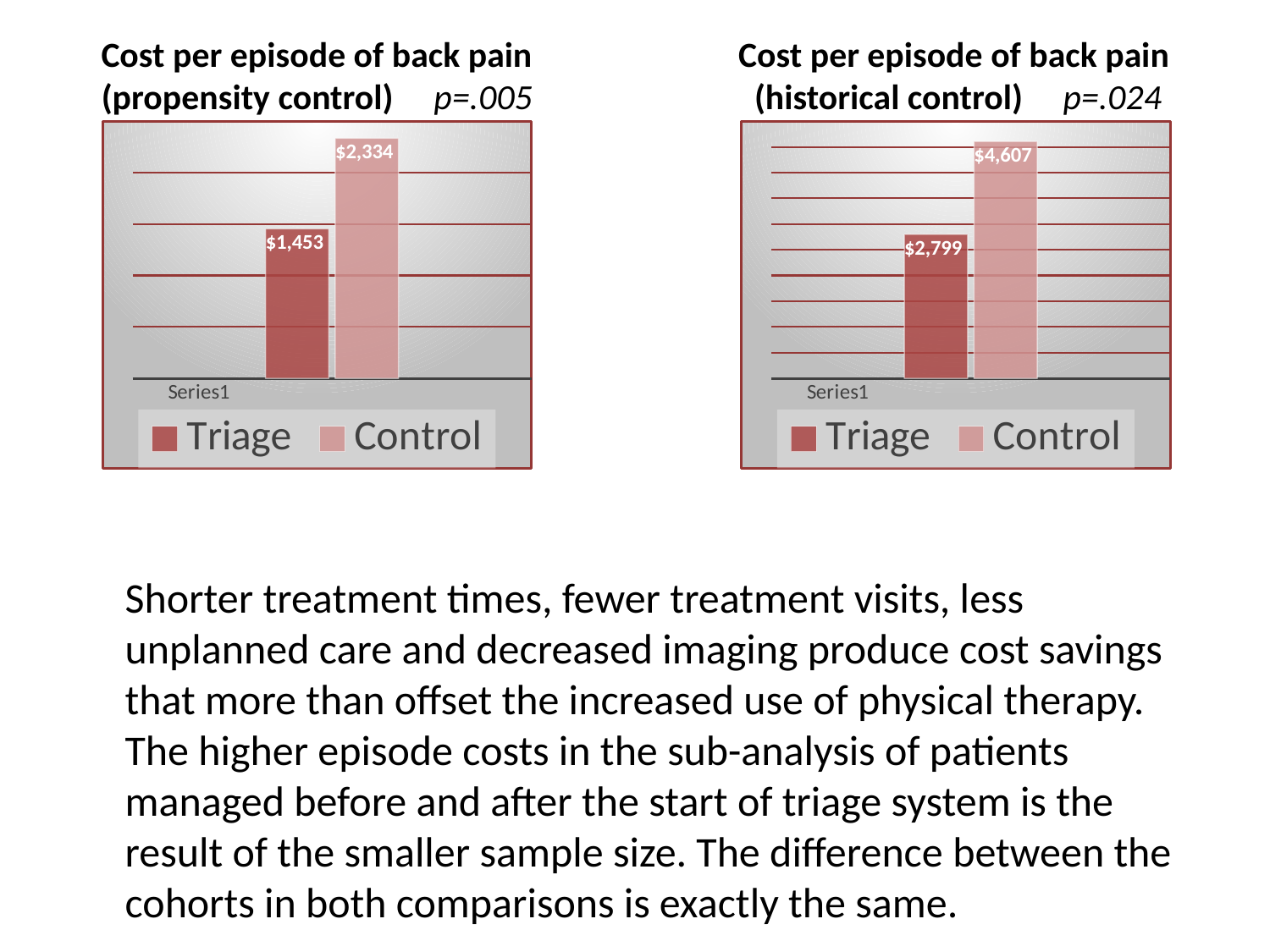
How many series does the legend of the historical control chart list? 2 In the historical control chart, what is the cost per episode for Control? $4,607 What kind of chart is the propensity control chart? bar chart Is the Triage cost in the historical control chart larger or smaller than the Control cost in the propensity control chart? larger In the propensity control chart, what is the cost per episode for Control? $2,334 In the propensity control chart, what is the cost per episode for Triage? $1,453 What p-value is shown next to the title of the historical control chart? p=.024 In the propensity control chart, which series has the higher cost per episode? Control In the historical control chart, what is the difference between the Control and Triage costs? $1,808 In the historical control chart, what is the cost per episode for Triage? $2,799 In the propensity control chart, what is the difference between the Control and Triage costs? $881 In the historical control chart, which series has the lower cost per episode? Triage